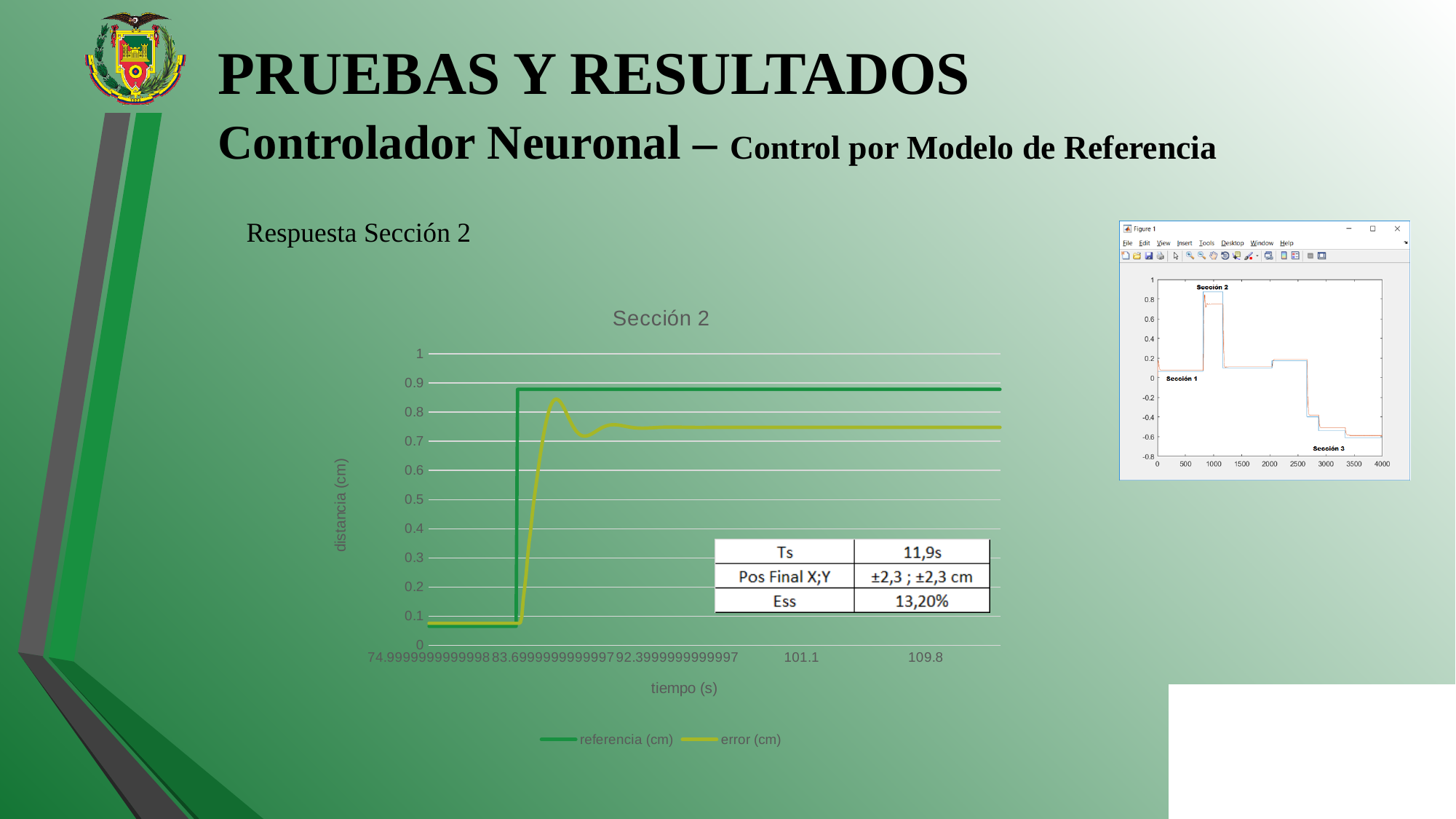
How many labelled tick marks are shown on the x axis of the 'Sección 2' chart? 5 In the 'Sección 2' chart, is the peak value reached by the error (cm) line greater or less than 0.8? greater In the 'Sección 2' chart, does the referencia (cm) line rise or fall as time increases along the x axis? rises In the 'Sección 2' chart, is the final value of the referencia (cm) line greater or less than 0.8? greater In the 'Sección 2' chart, is the value of the referencia (cm) line before the step (at the left of the chart) greater or less than 0.1? less How many series does the legend of the 'Sección 2' chart list? 2 What kind of chart is the 'Sección 2' chart? line chart In the 'Sección 2' chart, at the right end of the x axis, which series has the higher value, referencia (cm) or error (cm)? referencia (cm) What is the label of the y axis of the 'Sección 2' chart? distancia (cm) What are the two series named in the legend of the 'Sección 2' chart? referencia (cm) and error (cm)